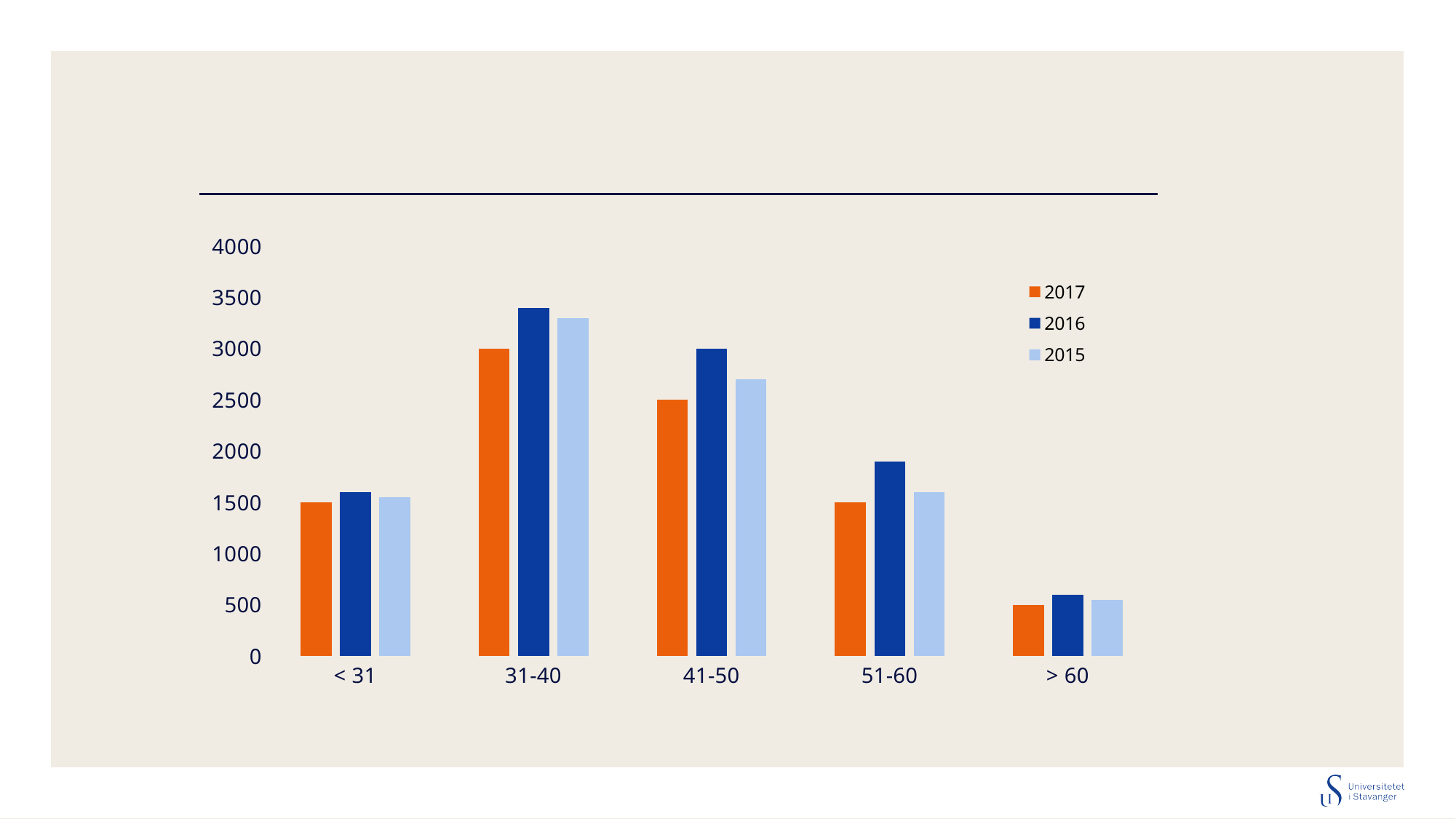
In the 41-50 category, which is larger: the 2016 value or the 2015 value? 2016 Which category has the highest value for the 2016 series? 31-40 Is the 2016 value for 31-40 greater or less than 3000? greater Which colour represents the 2017 series in the legend? orange Which category has the lowest value for the 2017 series? > 60 What kind of chart is shown on the slide? bar chart Is the 2017 value for > 60 greater or less than 1000? less Is the 2015 value for 41-50 greater or less than 2500? greater In the 51-60 category, which is larger: the 2016 value or the 2017 value? 2016 How many series does the legend list? 3 How many age categories are shown on the x axis? 5